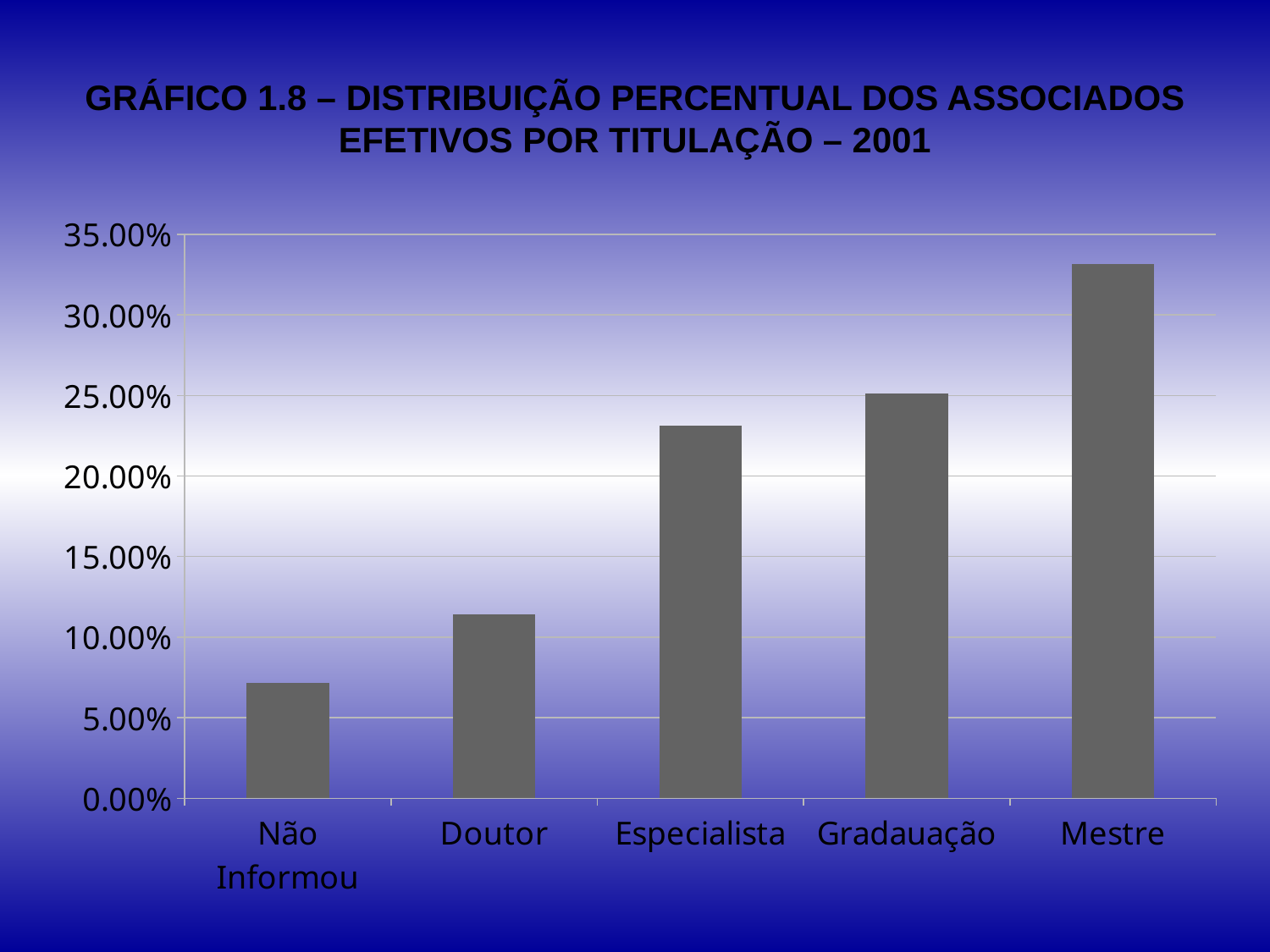
What kind of chart is shown on the slide? bar chart Which category has the lowest value in the chart? Não Informou Which category has the highest value in the chart? Mestre Is the value for Não Informou greater or less than 10.00%? less Do the bar values rise or fall from left to right across the x axis? rise Is the value for Mestre greater or less than 30.00%? greater Which is larger, the value for Doutor or the value for Especialista? Especialista How many categories are shown on the x axis of the chart? 5 What year is given in the chart title? 2001 Is the value for Doutor greater or less than 15.00%? less